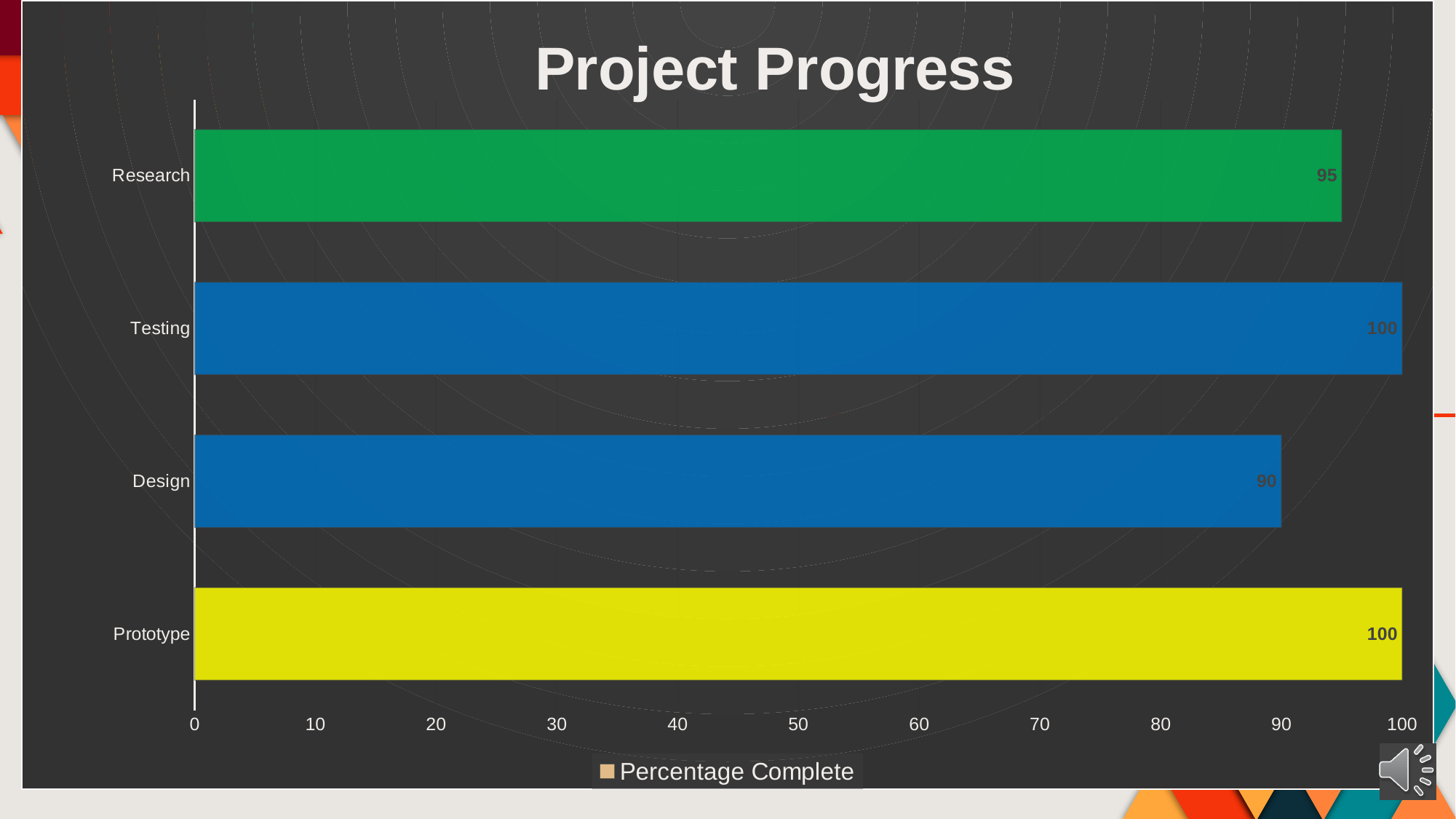
How many categories are shown in the chart? 4 How many series does the legend list? 1 What is the difference between the values for Testing and Design? 10 Is the value for Design greater or less than 80? greater What is the value for Prototype? 100 What kind of chart is shown on the slide? bar chart Which category has the lowest value? Design What is the value for Testing? 100 What is the value for Design? 90 Which is larger, the value for Research or the value for Design? Research What is the difference between the values for Research and Design? 5 What is the value for Research? 95